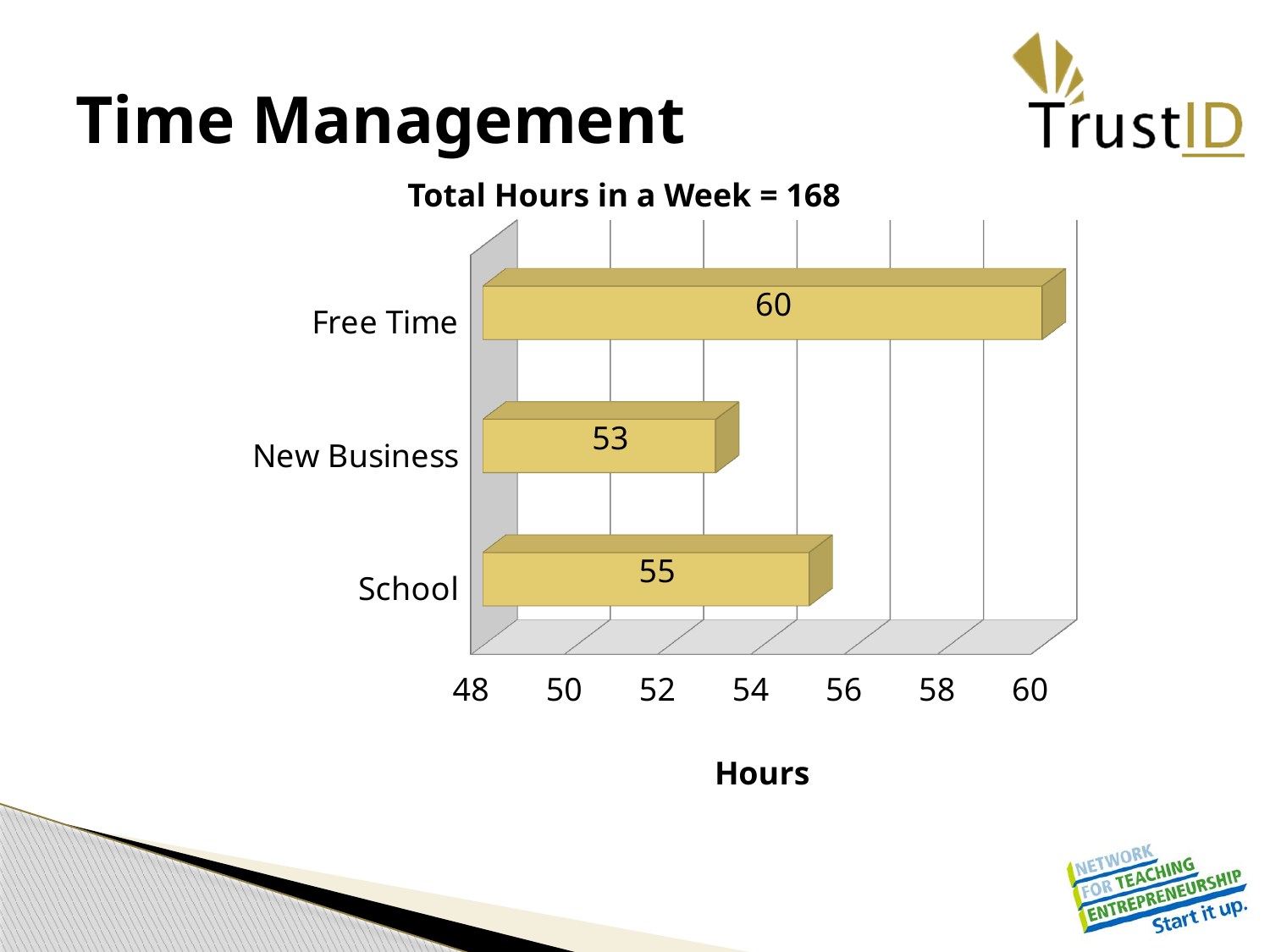
What value is shown for New Business? 53 How many categories are shown in the chart? 3 What value is shown for School? 55 What is the title of the chart? Total Hours in a Week = 168 Is the value for School greater or less than 54? greater What is the difference between the values for School and New Business? 2 What kind of chart is shown on the slide? bar chart Which is larger, the value for School or the value for New Business? School Which category has the highest value? Free Time Which category has the lowest value? New Business What is the difference between the values for Free Time and New Business? 7 What value is shown for Free Time? 60